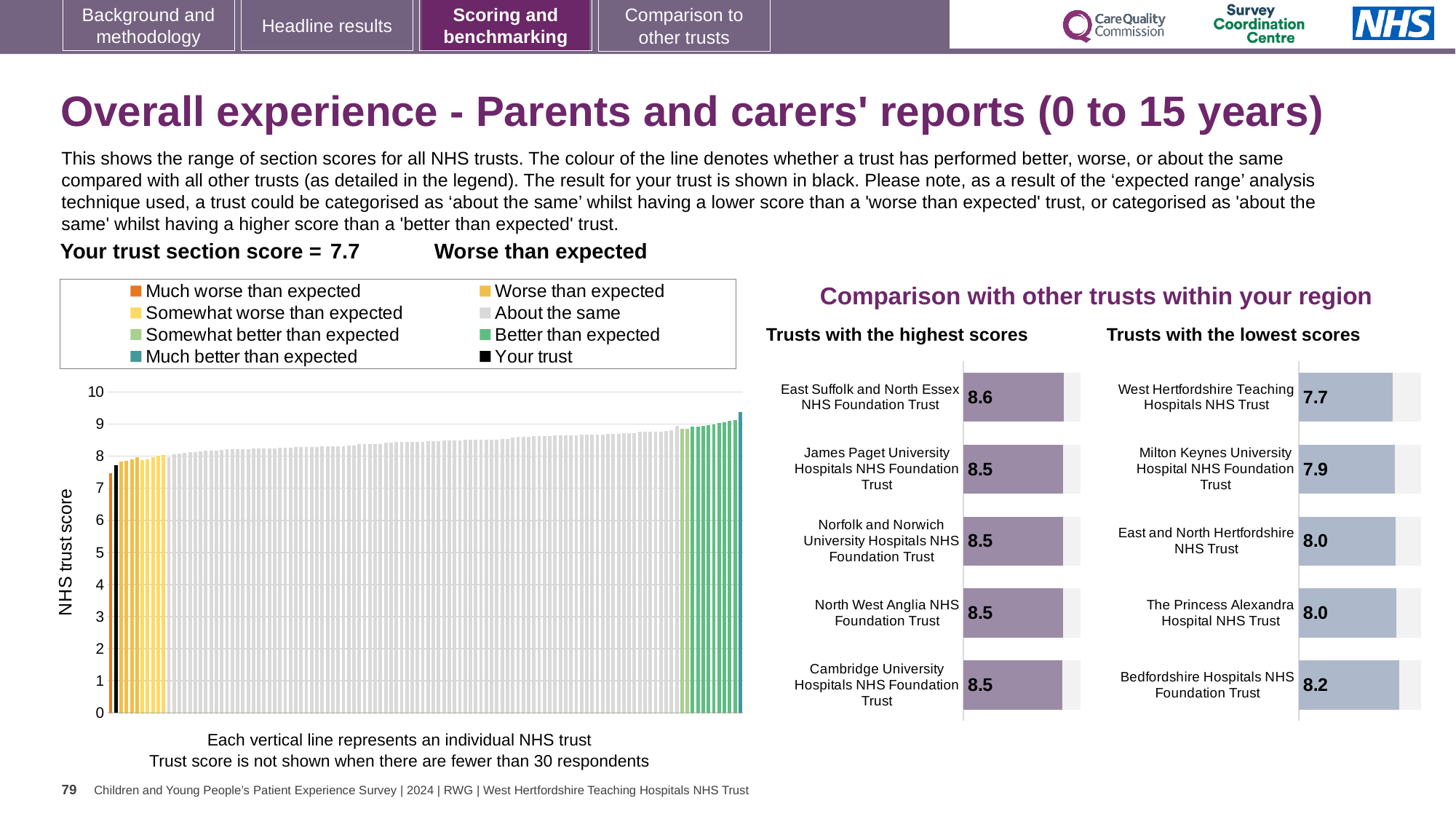
What kind of chart is the main chart on the left showing all NHS trusts? bar chart How many trusts are listed in the 'Trusts with the highest scores' chart? 5 In the 'Trusts with the lowest scores' chart, which trust has the lowest score? West Hertfordshire Teaching Hospitals NHS Trust In the 'Trusts with the lowest scores' chart, what is the score for Milton Keynes University Hospital NHS Foundation Trust? 7.9 In the 'Trusts with the highest scores' chart, which trust has the highest score? East Suffolk and North Essex NHS Foundation Trust In the 'Trusts with the highest scores' chart, what is the score for East Suffolk and North Essex NHS Foundation Trust? 8.6 In the 'Trusts with the lowest scores' chart, which has the higher score: Milton Keynes University Hospital NHS Foundation Trust or The Princess Alexandra Hospital NHS Trust? The Princess Alexandra Hospital NHS Trust How many entries does the legend of the main chart on the left list? 8 In the main chart on the left, is the value for 'Your trust' greater or less than 8? less In the 'Trusts with the lowest scores' chart, what is the score for Bedfordshire Hospitals NHS Foundation Trust? 8.2 In the main chart on the left, do the trust scores rise or fall from left to right? rise What is the difference between the score for East Suffolk and North Essex NHS Foundation Trust in the highest scores chart and the score for West Hertfordshire Teaching Hospitals NHS Trust in the lowest scores chart? 0.9